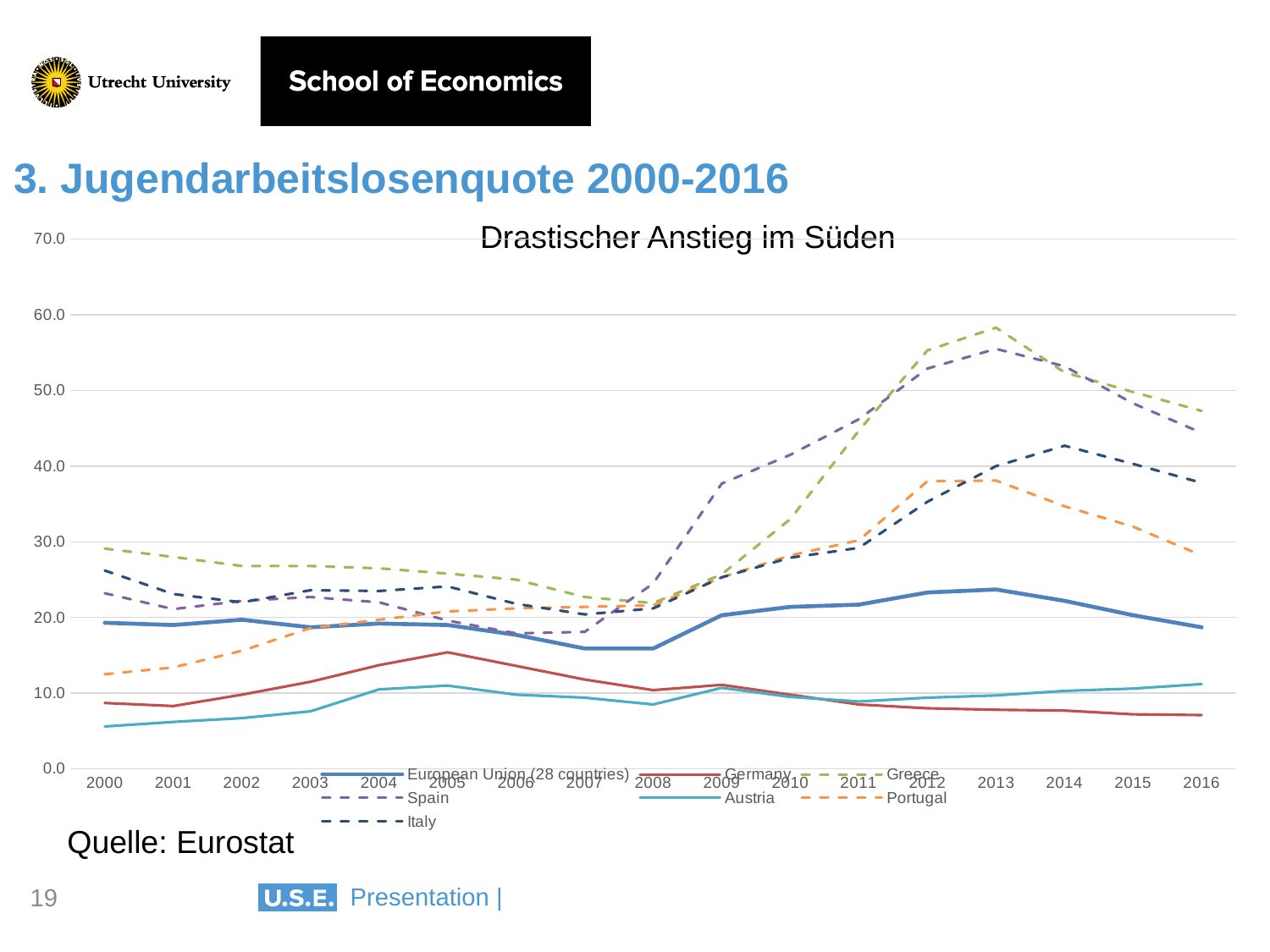
In 2012, which is larger: the value for Spain or the value for Italy? Spain Is the value for Portugal in 2016 greater or less than 30? less Is the value for Italy in 2014 greater or less than 40? greater What kind of chart is shown on the slide? line chart How many series does the legend list? 7 Is the value for Greece in 2013 greater or less than 50? greater Does the value for Greece rise or fall from 2008 to 2013? rise Which series has the lowest value in 2000? Austria What is the title of the chart? Drastischer Anstieg im Süden How many years are shown along the x axis? 17 Which series has the highest value in 2013? Greece